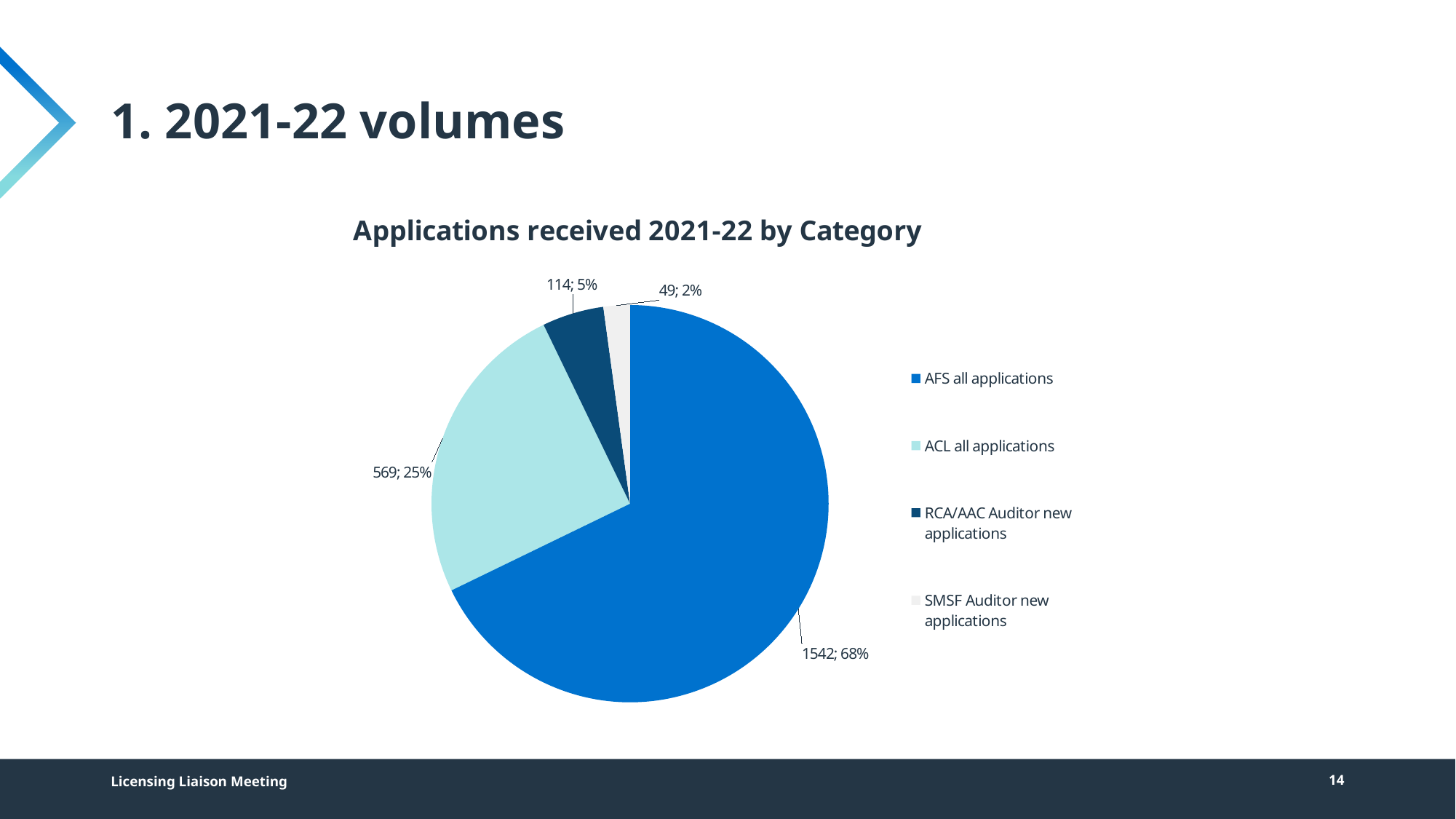
What is the difference between the number of AFS all applications and ACL all applications? 973 What kind of chart is shown on the slide? pie chart Which category has the largest share of applications? AFS all applications How many applications were received for AFS all applications? 1542 How many SMSF Auditor new applications were received? 49 Which is larger, RCA/AAC Auditor new applications or SMSF Auditor new applications? RCA/AAC Auditor new applications How many RCA/AAC Auditor new applications were received? 114 Which category has the smallest share of applications? SMSF Auditor new applications What percentage share of applications is ACL all applications? 25% What is the title of the chart? Applications received 2021-22 by Category How many categories does the legend list? 4 How many applications were received for ACL all applications? 569